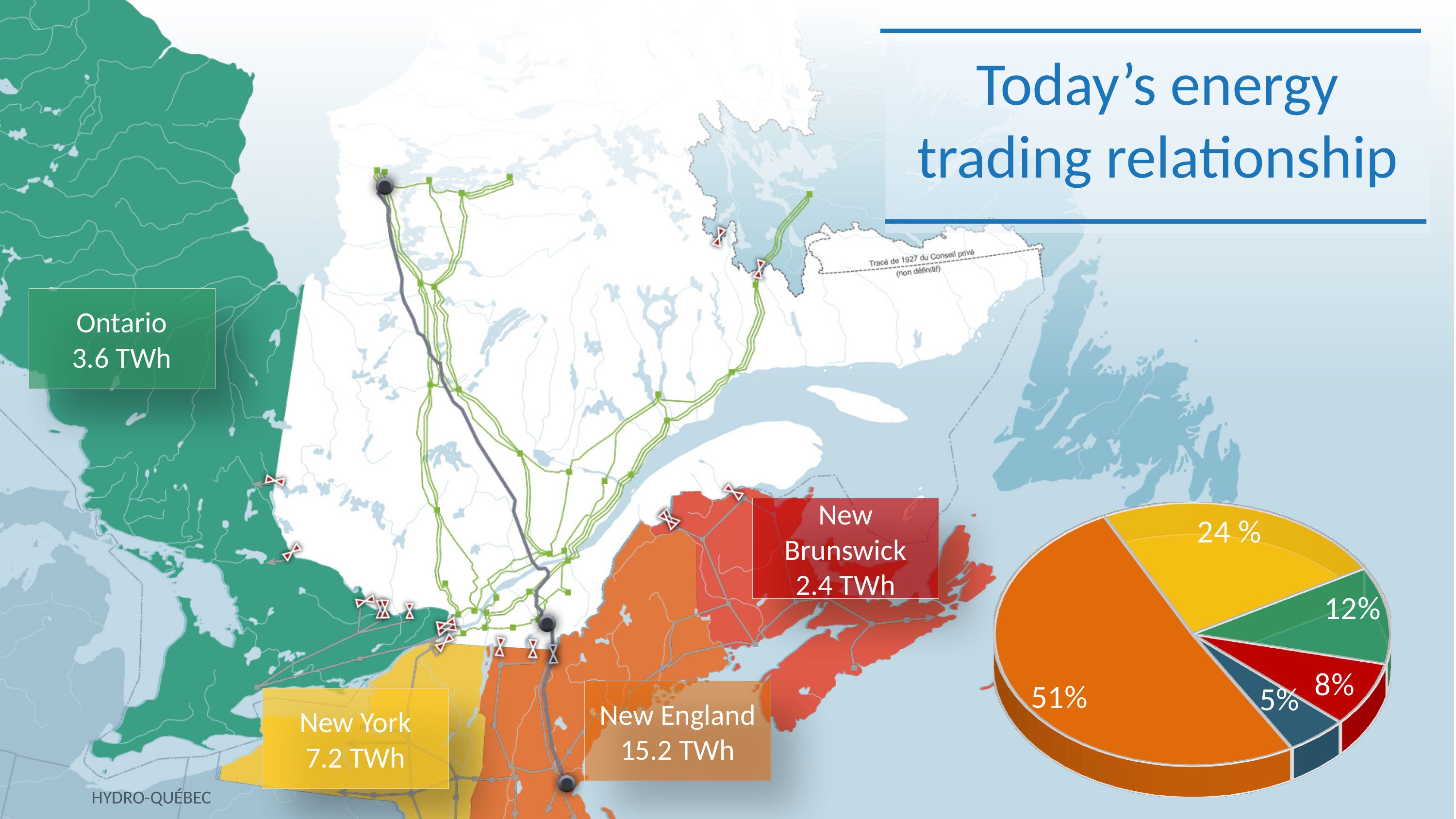
What colour is the largest slice of the pie chart? Orange How many slices does the pie chart have? 5 What is the combined share of the yellow (24 %) and green (12%) slices in the pie chart? 36% What is the title shown on the slide? Today's energy trading relationship What is the value of the largest slice in the pie chart? 51% What percentage is shown on the yellow slice of the pie chart? 24 % What is the difference between the largest slice (51%) and the second-largest slice (24 %) in the pie chart? 27 percentage points What is the value of the smallest slice in the pie chart? 5% What percentage is shown on the dark blue slice of the pie chart? 5% What percentage is shown on the orange slice of the pie chart? 51% In the pie chart, which is larger: the green slice or the red slice? The green slice (12%) What kind of chart is shown on the right side of the slide? Pie chart